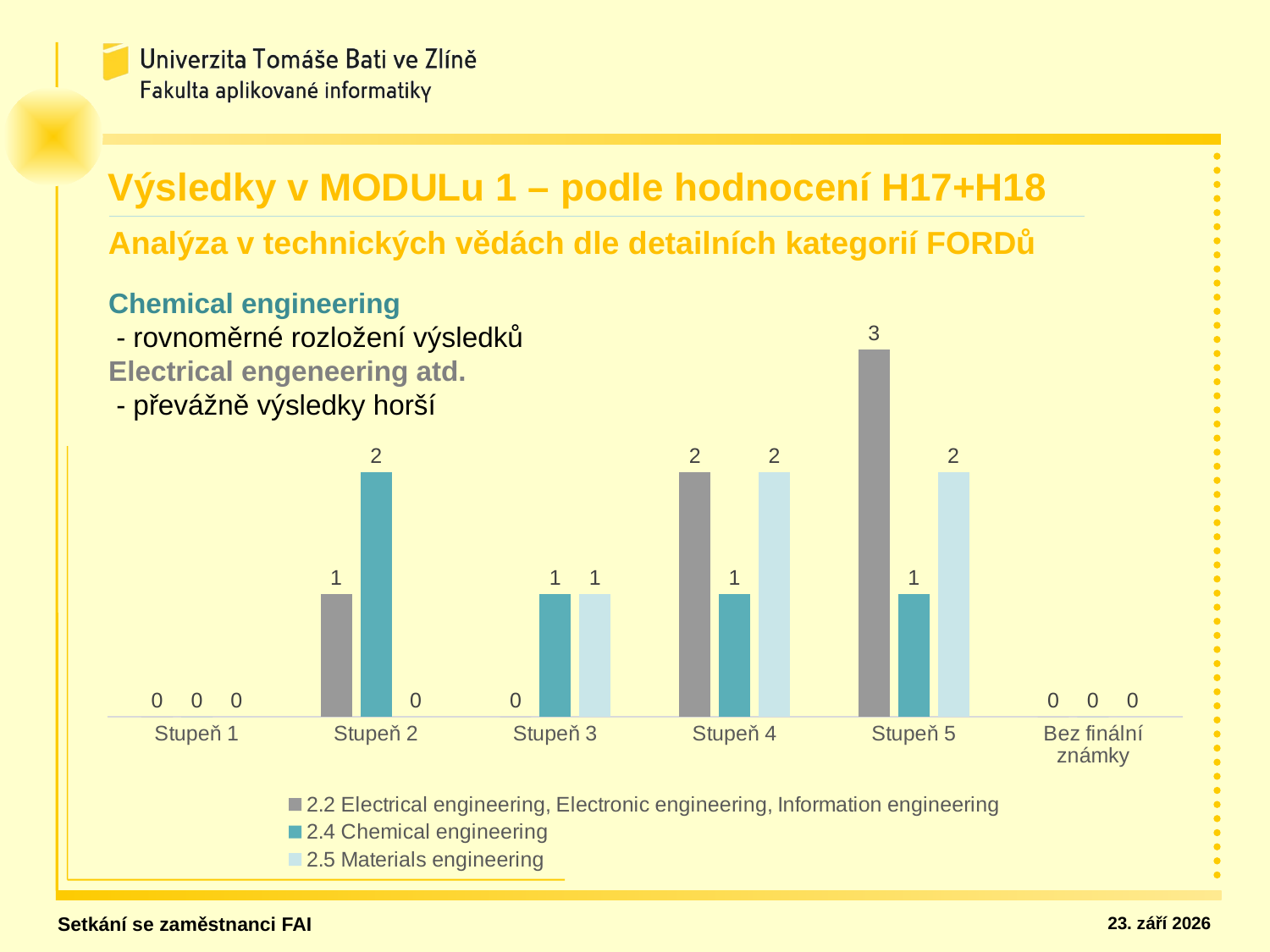
What kind of chart is shown on the slide? bar chart How many categories are shown on the x axis? 6 What is the total of the three series at Stupeň 4? 5 At Stupeň 2, which series has the larger value: 2.2 Electrical engineering or 2.4 Chemical engineering? 2.4 Chemical engineering Which series is shown in the lightest blue colour in the legend? 2.5 Materials engineering How many series does the legend list? 3 In which category does the 2.2 Electrical engineering, Electronic engineering, Information engineering series reach its highest value? Stupeň 5 What is the value for 2.4 Chemical engineering at Stupeň 2? 2 What is the value for 2.2 Electrical engineering, Electronic engineering, Information engineering at Stupeň 5? 3 What is the value for 2.5 Materials engineering at Stupeň 4? 2 What is the value for 2.5 Materials engineering at Stupeň 2? 0 What is the difference between the 2.2 Electrical engineering series and the 2.4 Chemical engineering series at Stupeň 5? 2